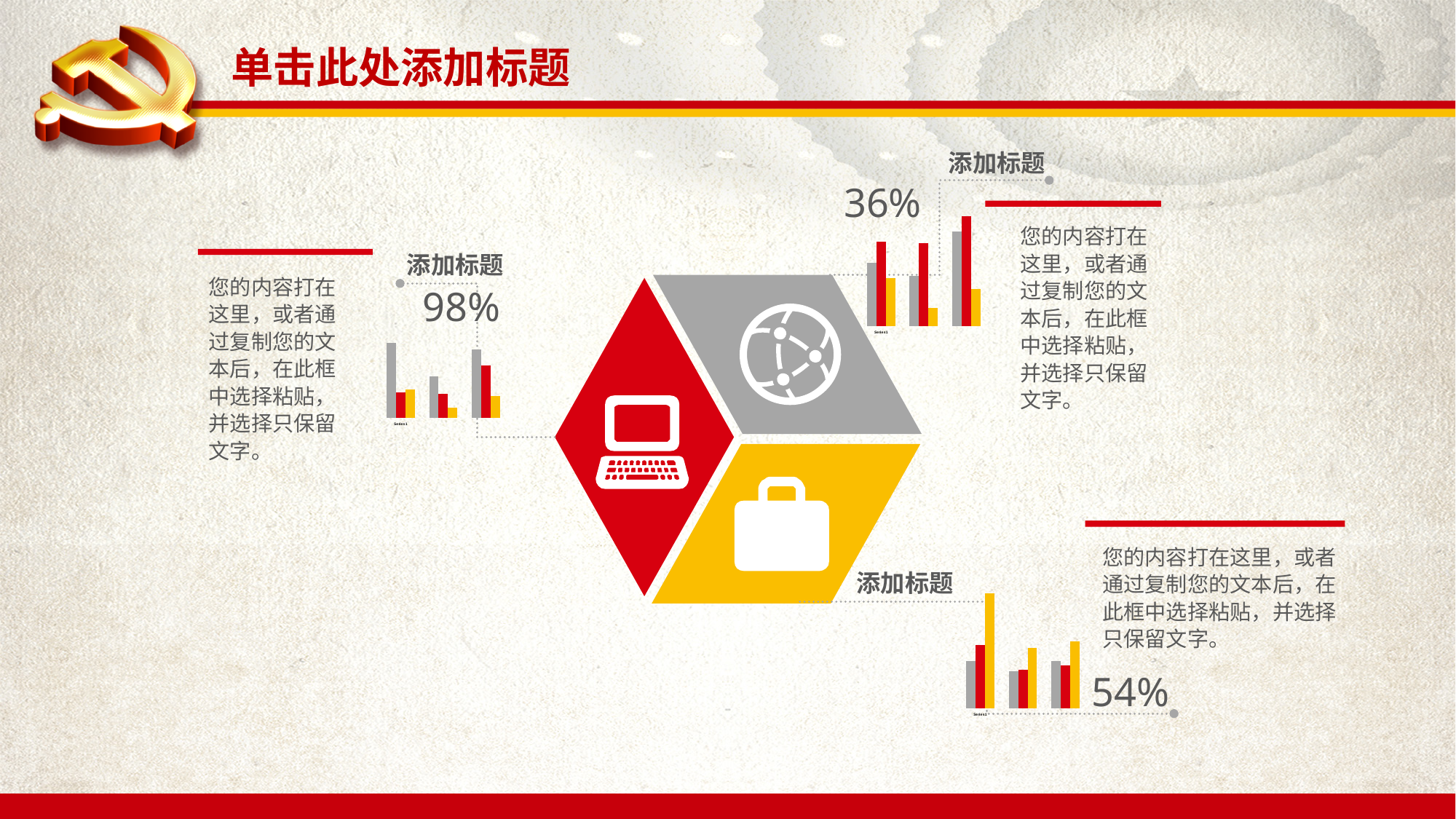
What kind of chart is shown next to the 54% figure at the bottom right of the slide? bar chart In the bar chart next to the 36% figure, in the second group of bars, is the red bar or the yellow bar taller? red What kind of chart is shown next to the 98% figure on the left of the slide? bar chart In the bar chart next to the 54% figure, in the first group of bars, is the yellow bar or the gray bar taller? yellow In the bar chart next to the 98% figure, how many groups of bars are there? 3 In the bar chart next to the 36% figure, how many bars are in each group? 3 How many small bar charts are on the slide? 3 In the bar chart next to the 54% figure, which colour bar is the tallest overall? yellow In the bar chart next to the 98% figure, in the first group of bars, is the gray bar or the red bar taller? gray What three colours are used for the bars in the charts on the slide? gray, red and yellow In the bar chart next to the 36% figure, which colour bar is the tallest overall? red